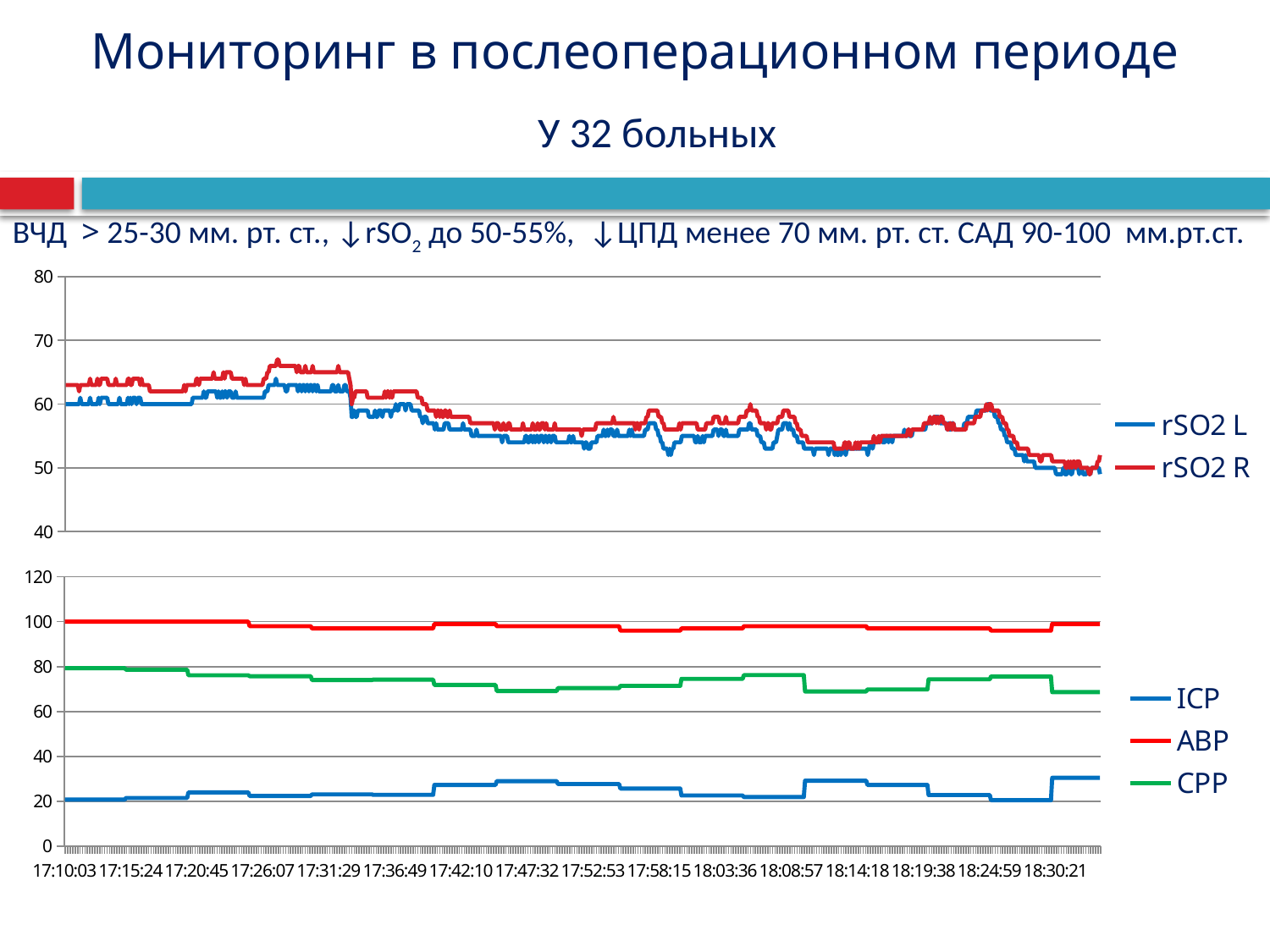
In the top chart, at the start of the recording, which series has the higher value, rSO2 L or rSO2 R? rSO2 R In the bottom chart, is the CPP value at 17:10:03 greater or less than 60? greater What type of chart is the top chart on the slide? line chart In the bottom chart, is the ICP value at 17:47:32 greater or less than 40? less How many series does the legend of the bottom chart list? 3 In the bottom chart, which series has the lowest values throughout the recording? ICP In the top chart, is the value of rSO2 R at the start of the recording (17:10:03) greater or less than 60? greater In the top chart, do the rSO2 L values overall rise or fall from the start to the end of the time axis? fall In the bottom chart, which series has the highest values throughout the recording? ABP In the bottom chart, which series is drawn in green? CPP In the top chart, which series is drawn in red? rSO2 R How many series does the legend of the top chart list? 2